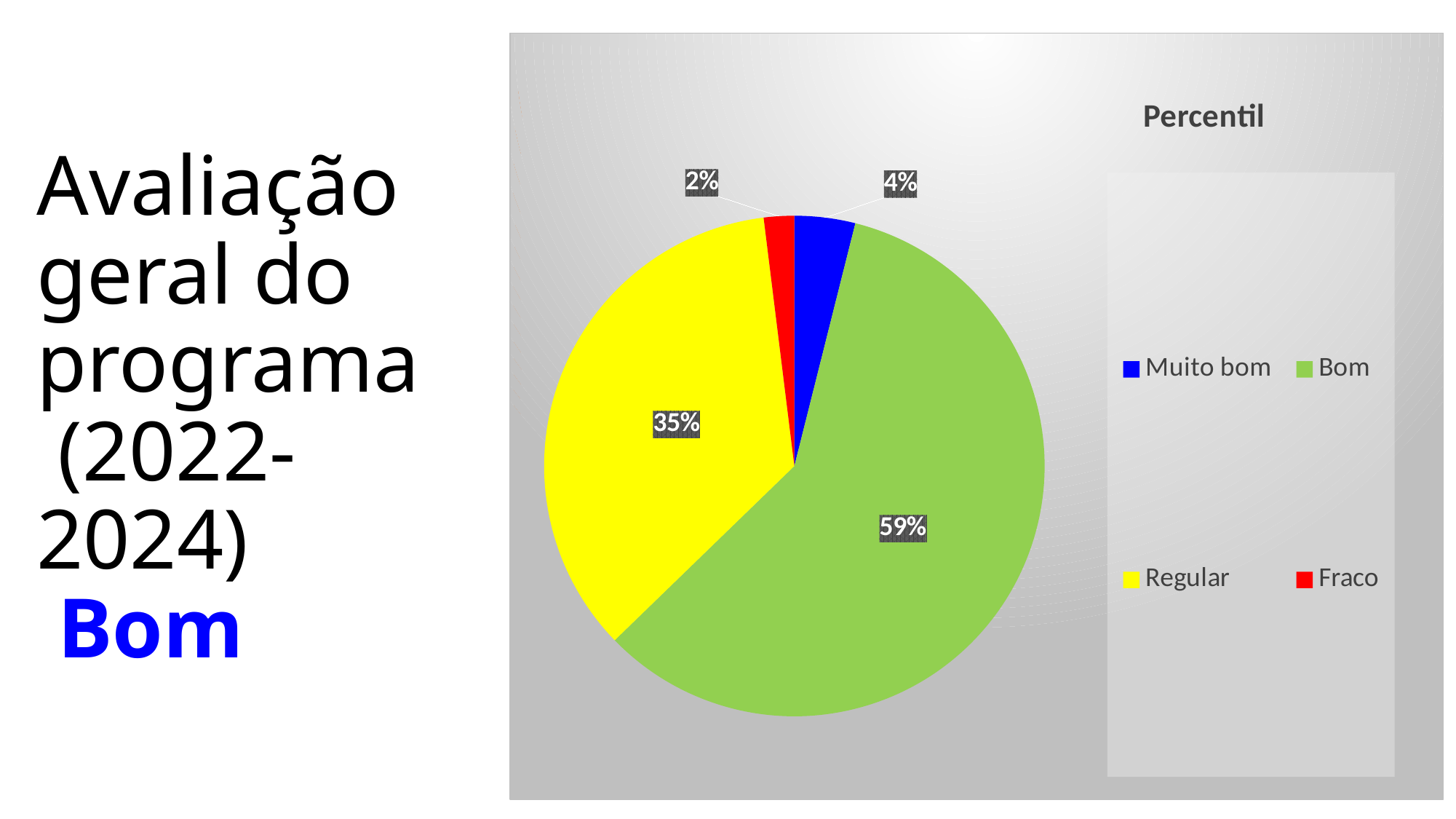
What percentage does the Fraco slice represent? 2% What is the difference in percentage points between the Bom and Regular slices? 24 What percentage does the Muito bom slice represent? 4% What colour is the Regular slice? yellow Which is larger, the Muito bom slice or the Fraco slice? Muito bom What is the title of the chart? Percentil What kind of chart is shown on the slide? pie chart What percentage does the Regular slice represent? 35% What percentage does the Bom slice represent? 59% How many categories does the legend list? 4 Which category has the smallest share of the pie? Fraco Which category has the largest share of the pie? Bom